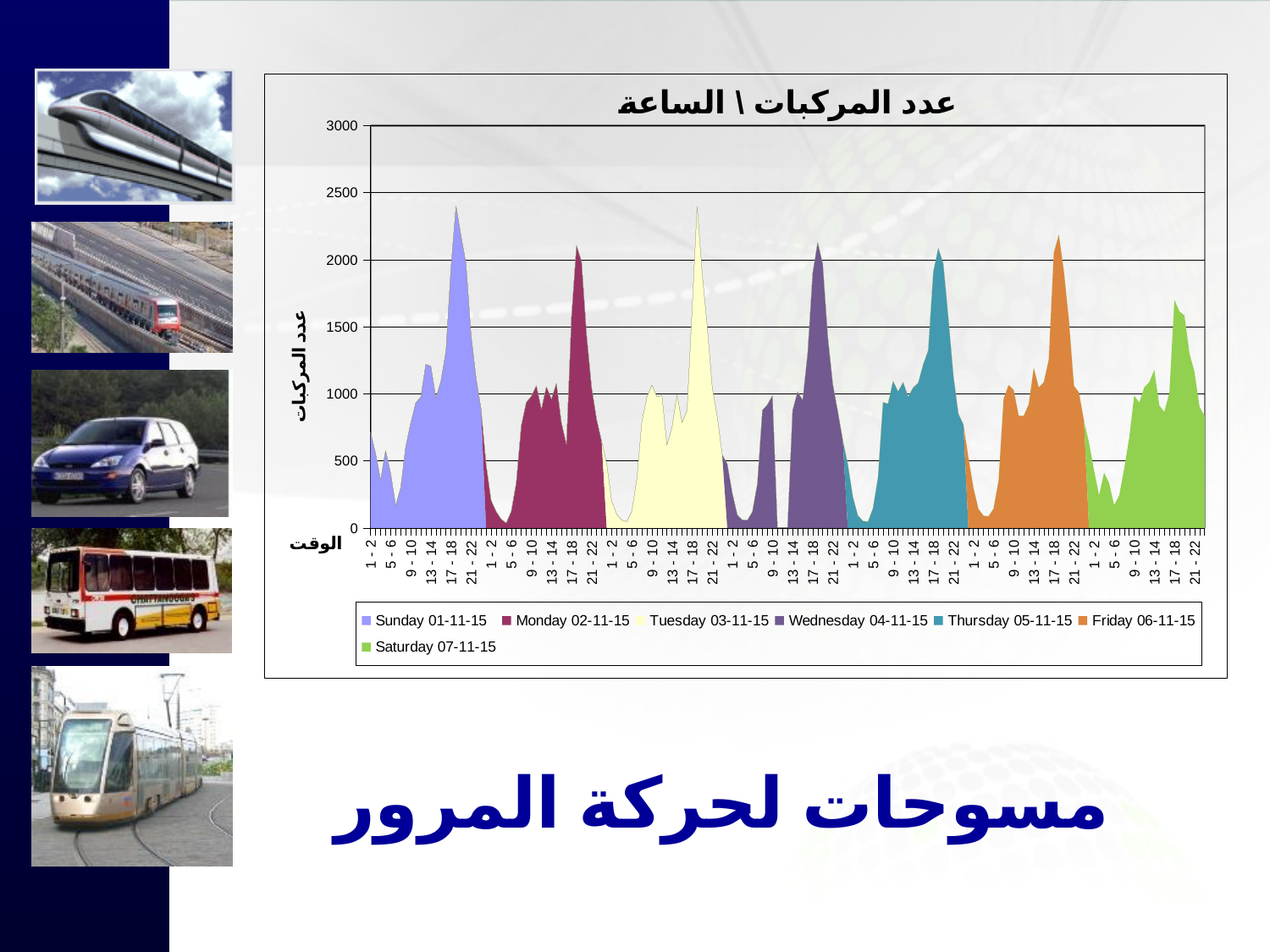
Is the peak value for Saturday 07-11-15 greater or less than 1500? greater What is the title of the chart? عدد المركبات \ الساعة Which legend entry is shown in green? Saturday 07-11-15 How many series does the chart's legend list? 7 Is the peak value for Sunday 01-11-15 greater or less than 2000? greater Is the peak value for Saturday 07-11-15 greater or less than 2000? less What is the highest value shown on the chart's vertical axis? 3000 Which day's series has the lowest peak value on the chart? Saturday 07-11-15 What kind of chart is shown on the slide? Area chart Is the peak value for Sunday 01-11-15 larger or smaller than the peak value for Saturday 07-11-15? larger